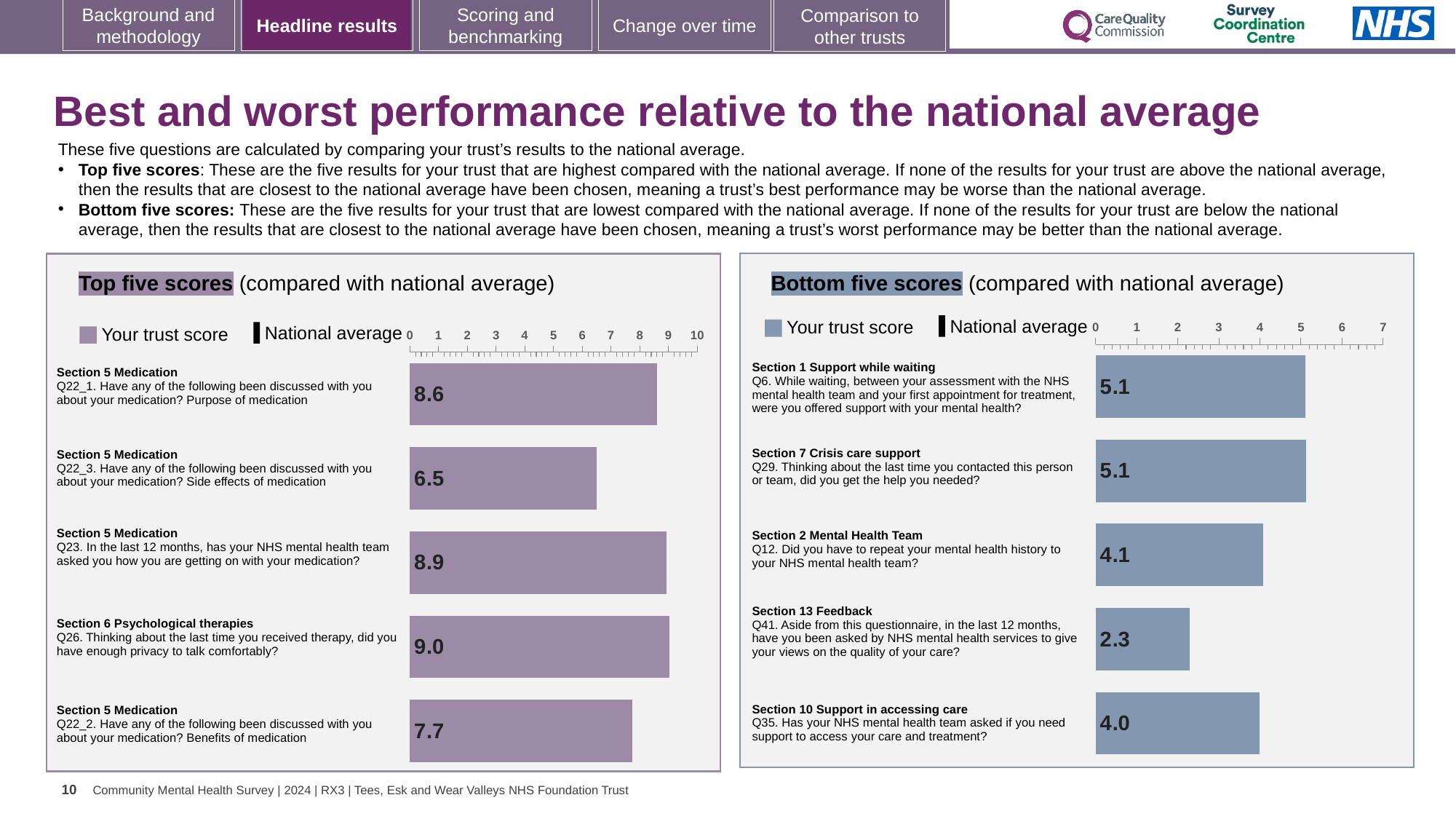
In the Bottom five scores chart, what is the trust score for Q41 (asked by NHS mental health services for views on quality of care)? 2.3 In the Bottom five scores chart, which question has the lowest trust score? Q41 (Section 13 Feedback) In the Top five scores chart, which question has the lowest trust score? Q22_3 (Section 5 Medication, side effects) In the Bottom five scores chart, which has the larger trust score: Q12 or Q41? Q12 In the Top five scores chart, what is the trust score for Q22_3 (side effects of medication discussed)? 6.5 In the Top five scores chart, what is the difference between the trust scores for Q23 and Q22_2? 1.2 In the Bottom five scores chart, what is the difference between the trust scores for Q6 and Q35? 1.1 How many series does the legend of the Top five scores chart list? 2 In the Top five scores chart, what is the trust score for Q26 (enough privacy to talk comfortably during therapy)? 9.0 In the Bottom five scores chart, what is the trust score for Q12 (having to repeat mental health history)? 4.1 How many questions are plotted in the Bottom five scores chart? 5 In the Top five scores chart, which question has the highest trust score? Q26 (Section 6 Psychological therapies)